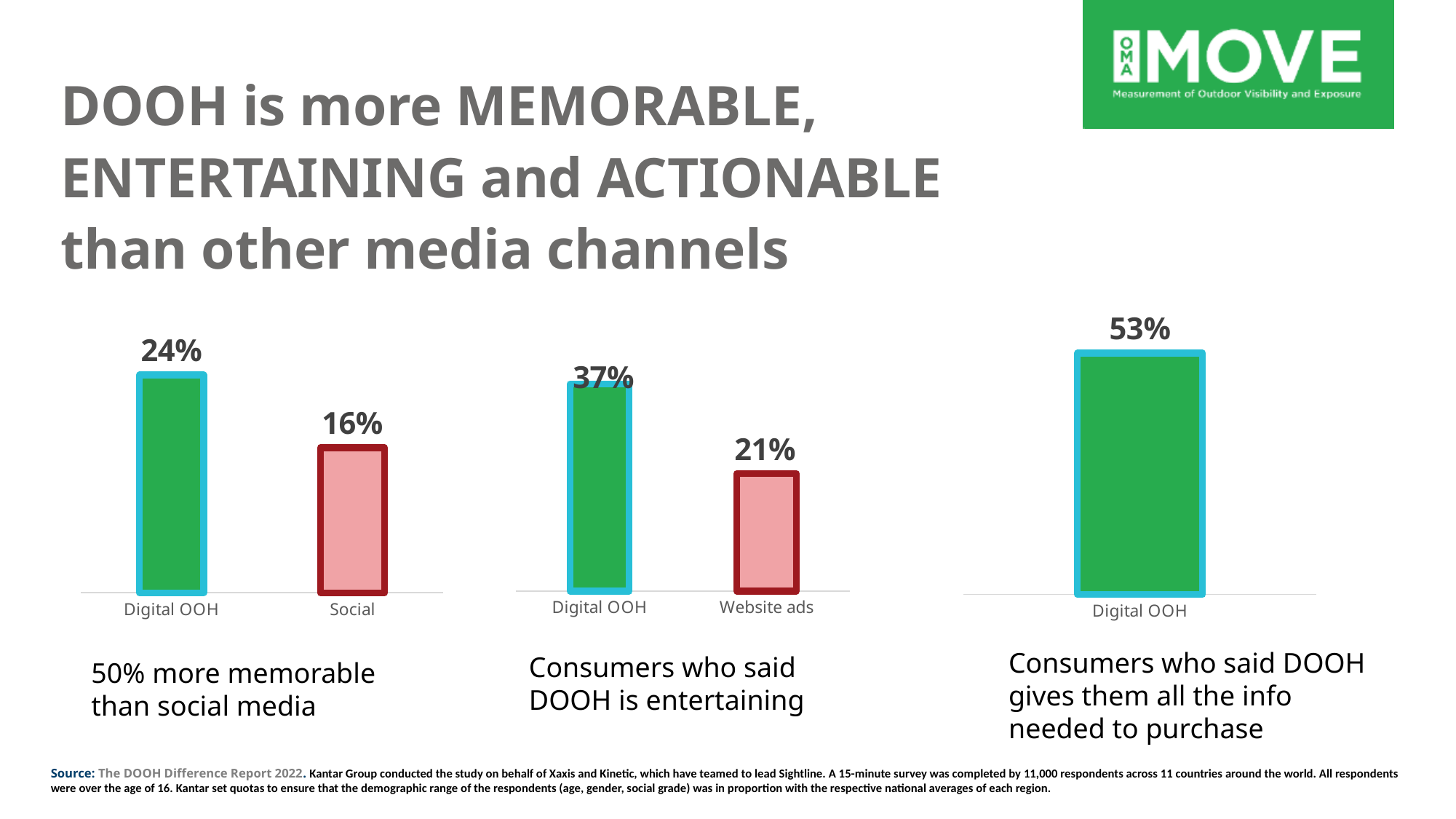
In the left chart (memorable vs social media), what is the value for Digital OOH? 24% In the left chart (memorable vs social media), what is the value for Social? 16% In the middle chart (DOOH is entertaining), which category has the higher value, Digital OOH or Website ads? Digital OOH How many bars are shown in the middle chart (DOOH is entertaining)? 2 In the middle chart (DOOH is entertaining), what is the difference between Digital OOH and Website ads? 16% In the left chart (memorable vs social media), which category has the lowest value? Social In the left chart (memorable vs social media), what is the difference between Digital OOH and Social? 8% What colour are the Digital OOH bars on the slide? Green In the middle chart (DOOH is entertaining), what is the value for Website ads? 21% In the right chart (all the info needed to purchase), what is the value for Digital OOH? 53% What kind of chart is the right chart (all the info needed to purchase)? Bar chart In the middle chart (DOOH is entertaining), what is the value for Digital OOH? 37%